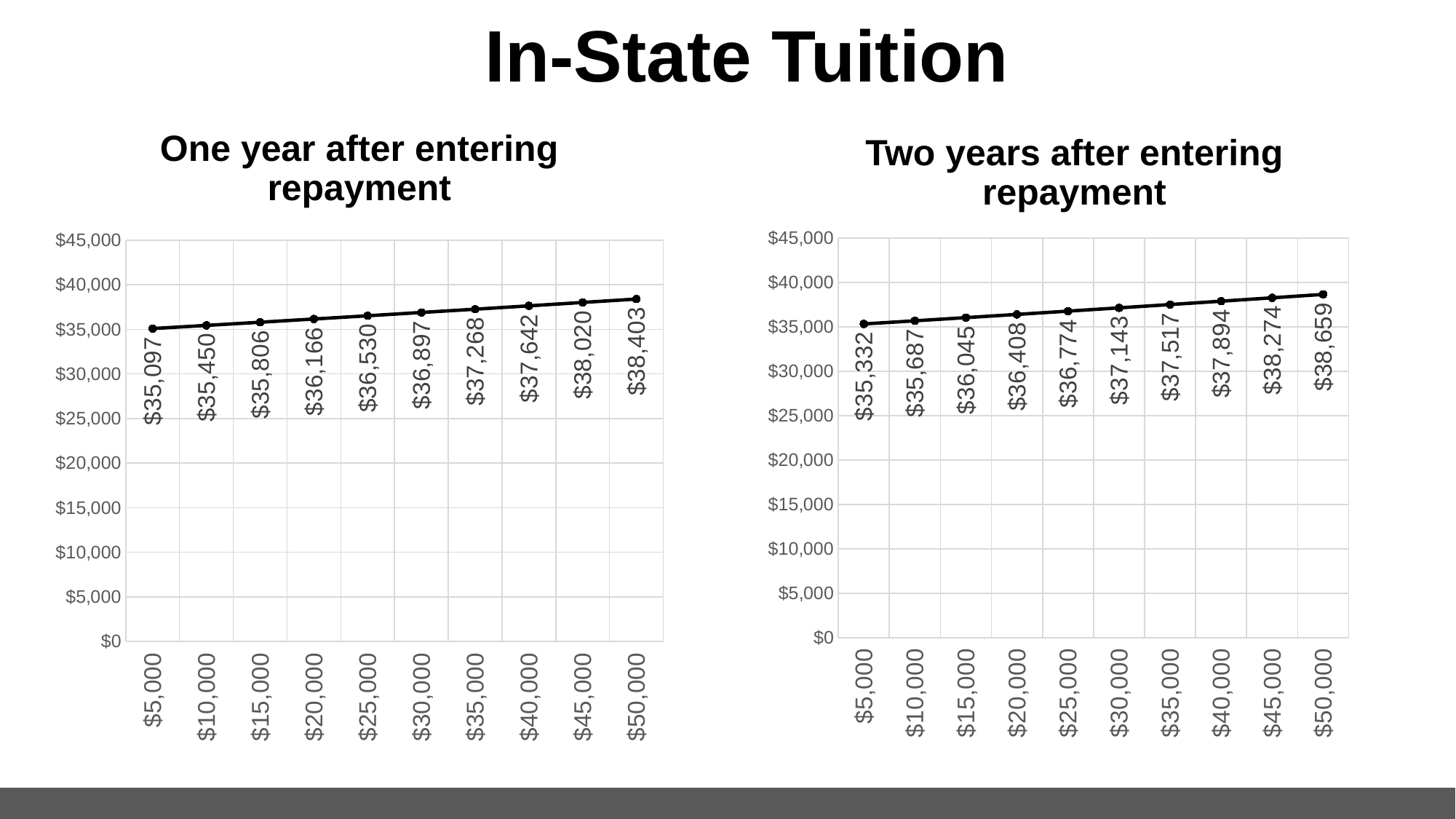
In the 'Two years after entering repayment' chart, what is the value at $20,000? $36,408 In the 'One year after entering repayment' chart, which x-axis category has the highest value? $50,000 In the 'Two years after entering repayment' chart, which x-axis category has the lowest value? $5,000 In the 'Two years after entering repayment' chart, what is the difference between the values at $10,000 and $5,000? $355 In the 'One year after entering repayment' chart, do the values rise or fall as the x-axis increases from $5,000 to $50,000? Rise Which is larger: the value at $25,000 in the 'One year after entering repayment' chart or the value at $25,000 in the 'Two years after entering repayment' chart? Two years after entering repayment In the 'Two years after entering repayment' chart, what is the value at $50,000? $38,659 In the 'One year after entering repayment' chart, what is the difference between the values at $50,000 and $5,000? $3,306 In the 'One year after entering repayment' chart, what is the value at $5,000? $35,097 In the 'One year after entering repayment' chart, what is the value at $30,000? $36,897 What type of chart is the 'Two years after entering repayment' chart? Line chart In the 'One year after entering repayment' chart, how many data points are plotted? 10